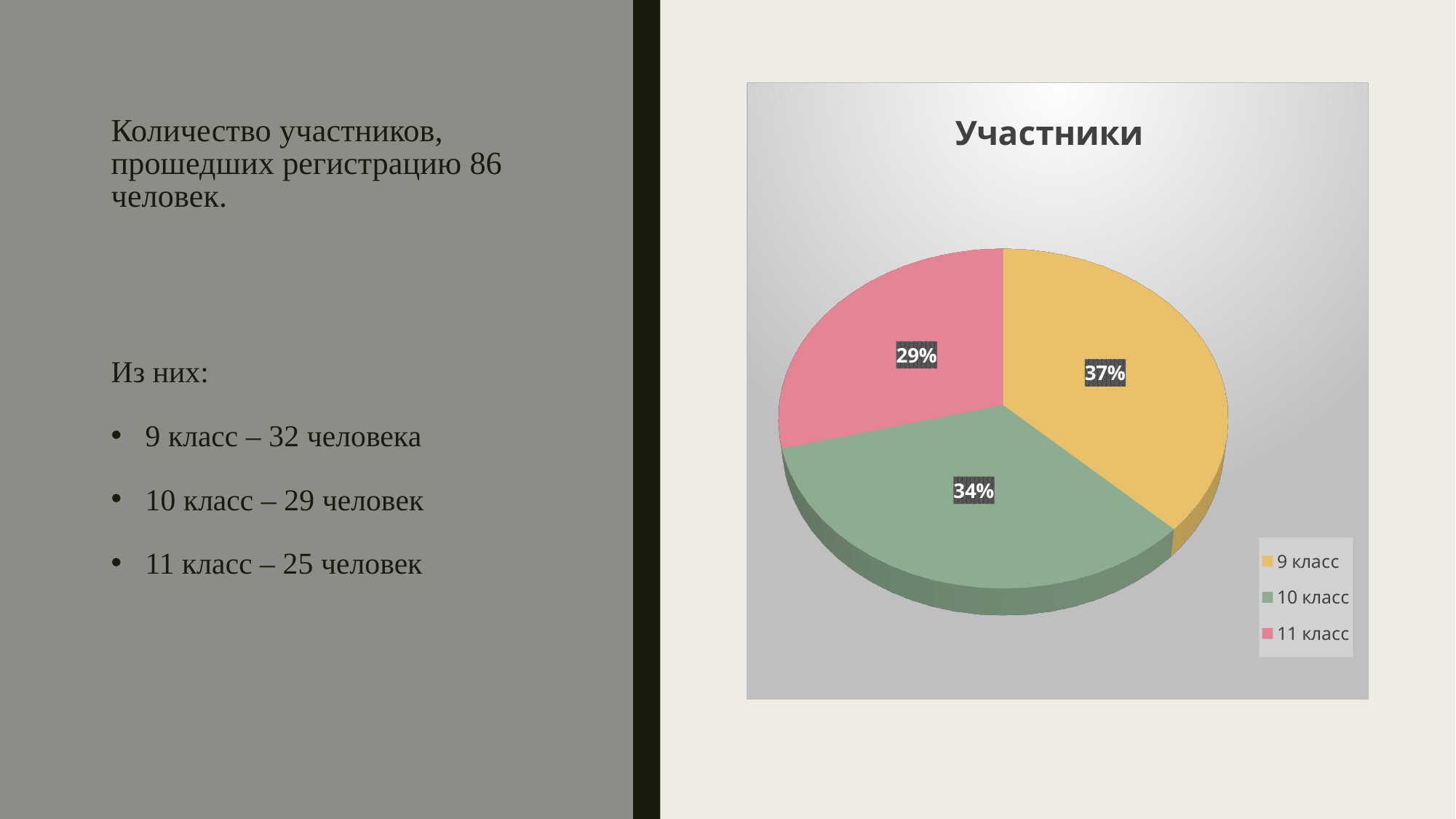
What is the title of the chart? Участники What percentage share does the 9 класс slice have? 37% Which category has the smallest slice of the pie? 11 класс Which slice is larger, 10 класс or 11 класс? 10 класс Which category has the largest slice of the pie? 9 класс What type of chart is shown on the slide? pie chart What colour is the 10 класс slice? green What is the difference in percentage points between the 9 класс and 11 класс slices? 8% What percentage share does the 11 класс slice have? 29% What percentage share does the 10 класс slice have? 34% How many slices does the pie chart have? 3 How many entries does the legend list? 3